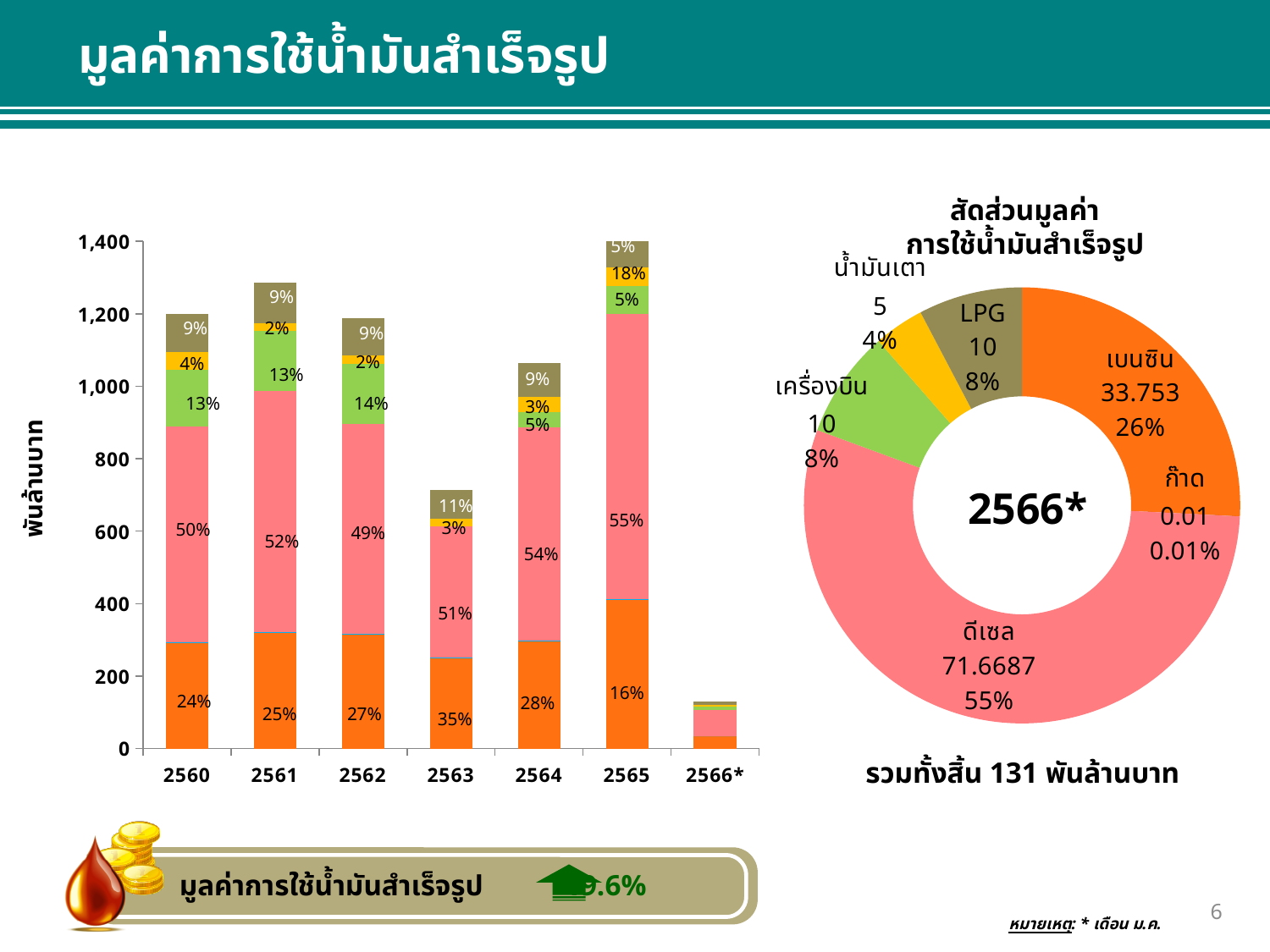
How many years are shown on the x axis of the bar chart on the left? 7 In the doughnut chart on the right, what share does เบนซิน have? 26% In the bar chart on the left, what percentage is labelled on the bottom orange segment of the 2563 bar? 35% What kind of chart is the chart on the right side of the slide? Doughnut chart In the doughnut chart on the right, which category has the largest slice? ดีเซล What kind of chart is the chart on the left side of the slide? Stacked bar chart In the doughnut chart on the right, what value is shown for ดีเซล? 71.6687 How many categories are shown in the doughnut chart on the right? 6 In the doughnut chart on the right, which category has the smallest slice? ก๊าด In the bar chart on the left, which year has the tallest bar? 2565 What total is stated below the doughnut chart on the right? 131 พันล้านบาท In the bar chart on the left, is the total height of the 2565 bar greater or less than 1,200? greater